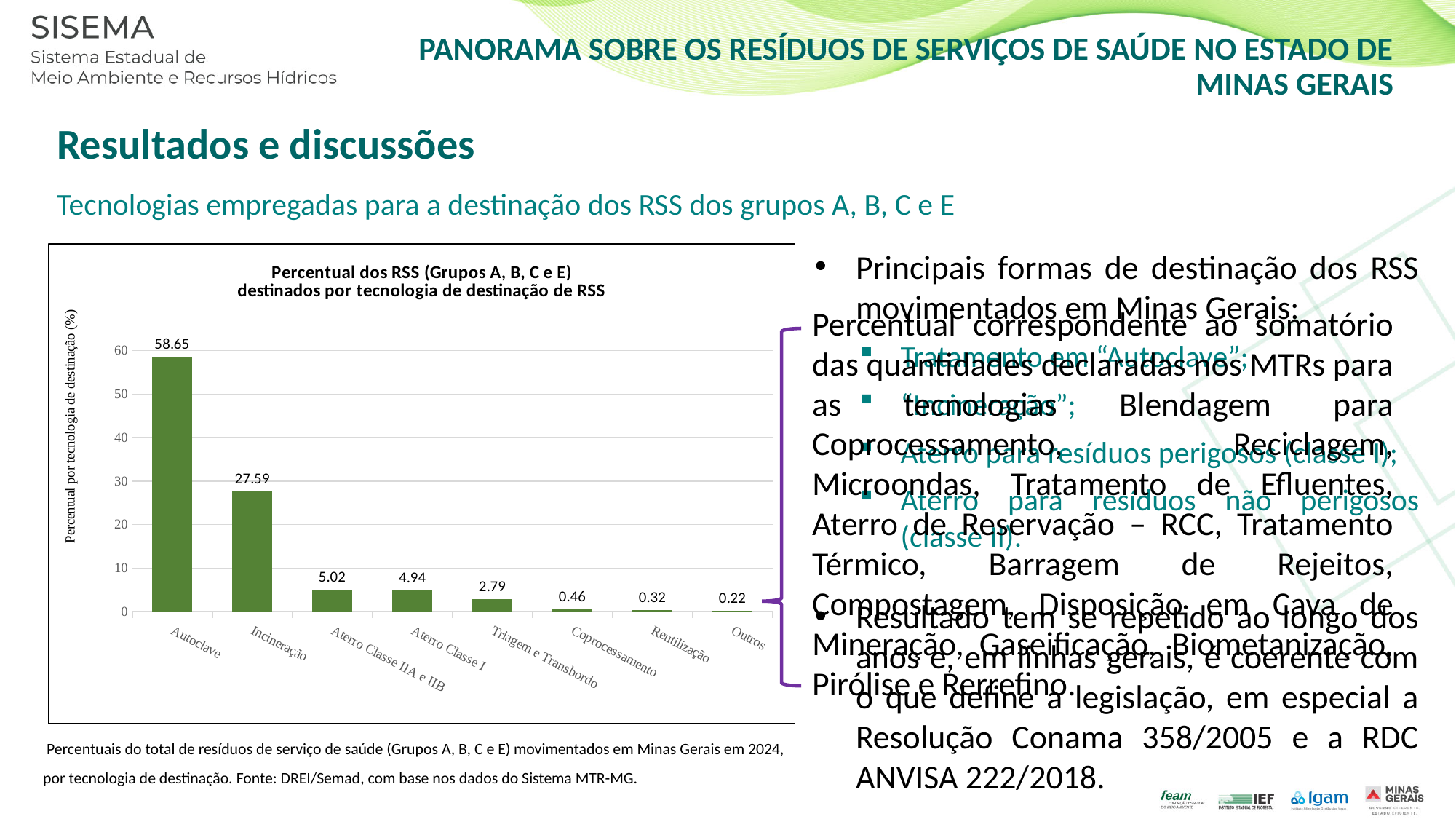
What is the value for Incineração? 27.59 Which category has the lowest value? Outros What is the value for Triagem e Transbordo? 2.79 What kind of chart is shown on the slide? Bar chart Which category has the highest value? Autoclave What is the difference between the values for Aterro Classe IIA e IIB and Aterro Classe I? 0.08 What is the label of the y axis? Percentual por tecnologia de destinação (%) What is the value for Reutilização? 0.32 How many categories are shown on the x axis? 8 What is the value for Autoclave? 58.65 Which is larger, the value for Coprocessamento or the value for Outros? Coprocessamento What is the difference between the values for Autoclave and Incineração? 31.06